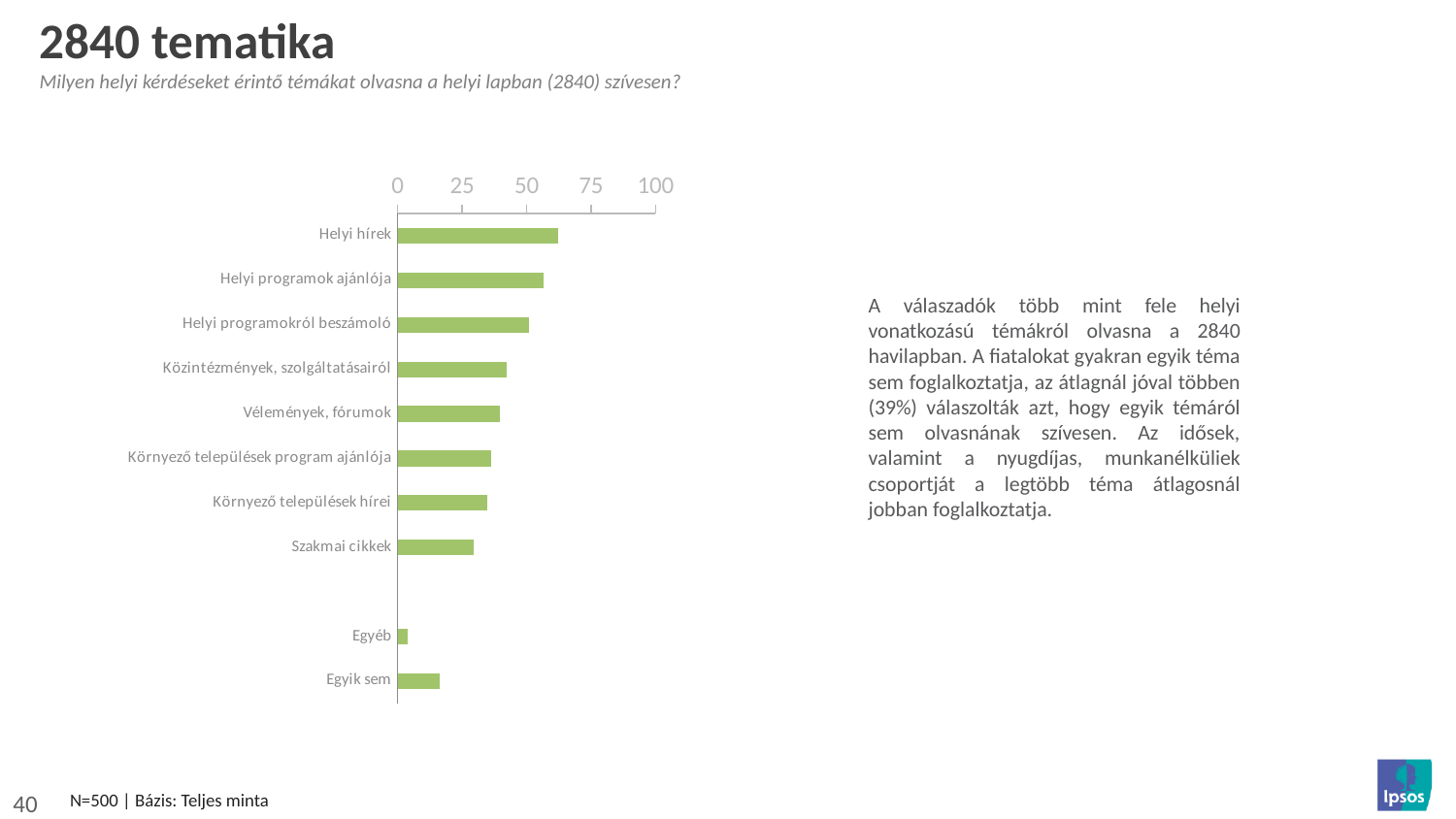
Is the value for Szakmai cikkek greater or less than 25? greater Which is larger, the value for Egyik sem or the value for Egyéb? Egyik sem What is the title of the slide containing the chart? 2840 tematika Which is larger, the value for Helyi hírek or the value for Szakmai cikkek? Helyi hírek How many categories are plotted in the chart? 10 Is the value for Helyi hírek greater or less than 50? greater Is the value for Egyéb greater or less than 25? less Which category has the longest bar in the chart? Helyi hírek What kind of chart is shown on the slide? bar chart Which category has the shortest bar in the chart? Egyéb